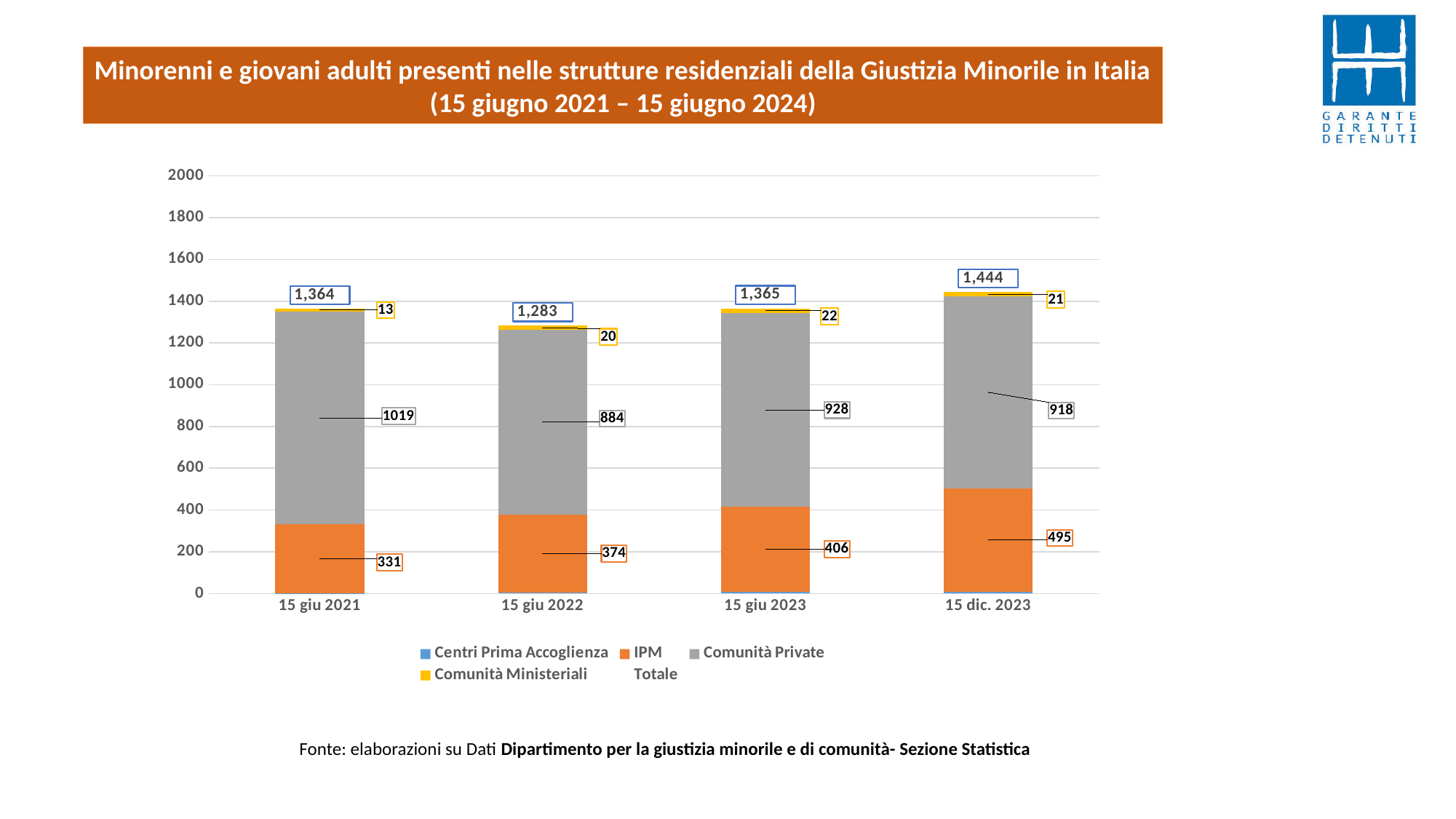
What is the total (Totale) shown for 15 dic. 2023? 1,444 What is the difference between the IPM values for 15 dic. 2023 and 15 giu 2021? 164 On which date is the IPM value highest? 15 dic. 2023 Which series is shown in orange in the legend? IPM What is the IPM value for 15 giu 2021? 331 Which is larger: the Comunità Private value for 15 giu 2023 or for 15 dic. 2023? 15 giu 2023 On which date is the total (Totale) lowest? 15 giu 2022 What is the Comunità Private value for 15 giu 2022? 884 How many dates (categories) are shown on the x axis? 4 How many series does the legend list? 5 What type of chart is shown on the slide? Stacked bar chart What is the Comunità Ministeriali value for 15 giu 2023? 22